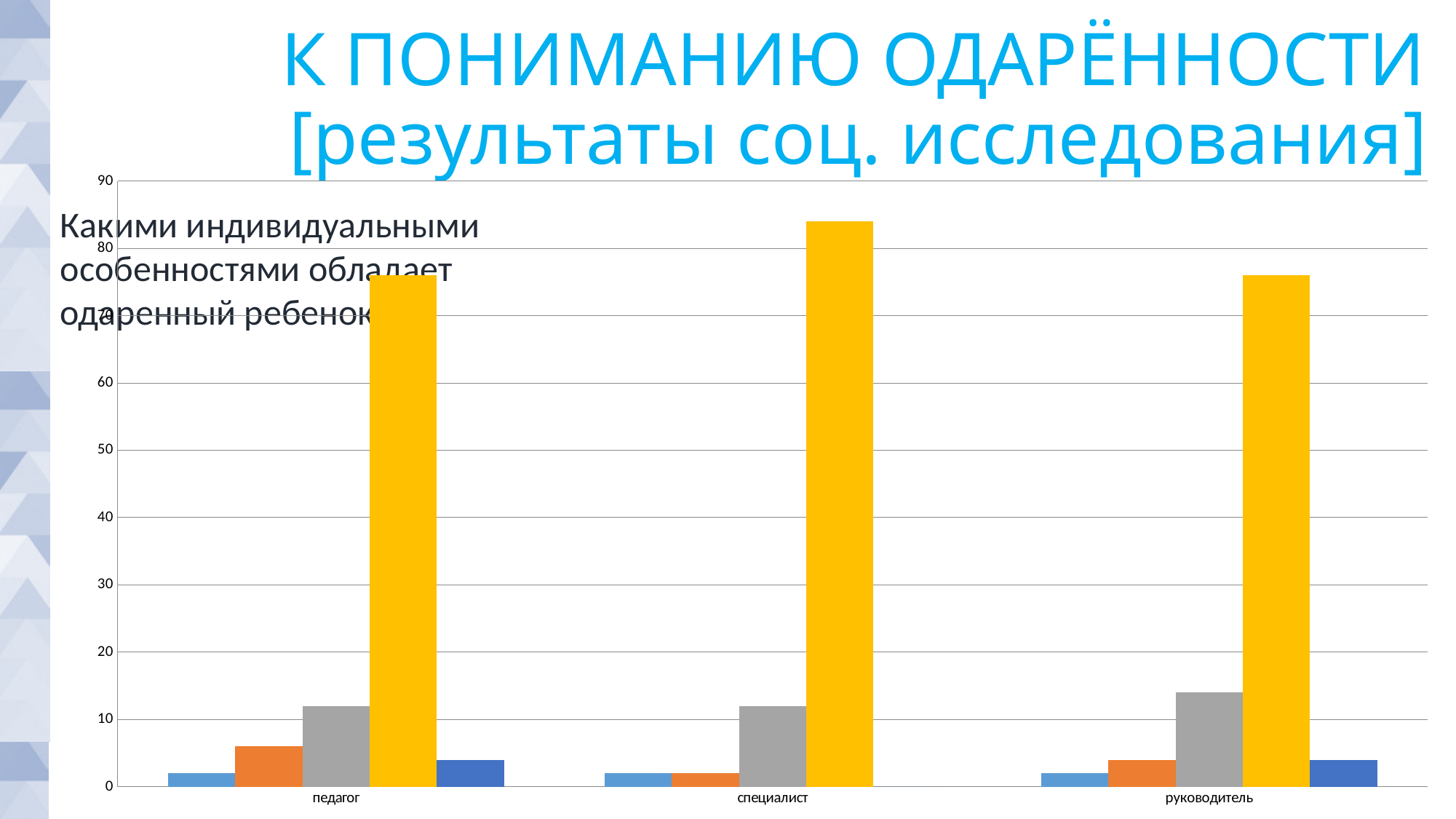
Is the yellow bar for руководитель greater or less than 80? less Which is larger: the grey bar for руководитель or the grey bar for педагог? руководитель Which is larger: the orange bar for педагог or the orange bar for специалист? педагог What kind of chart is shown on the slide? bar chart Is the yellow bar for специалист greater or less than 80? greater What is the title of the slide containing the chart? К ПОНИМАНИЮ ОДАРЁННОСТИ [результаты соц. исследования] How many categories are shown on the x axis of the chart? 3 Which category has the tallest yellow bar? специалист Is the orange bar for педагог greater or less than 10? less What is the highest value shown on the vertical axis of the chart? 90